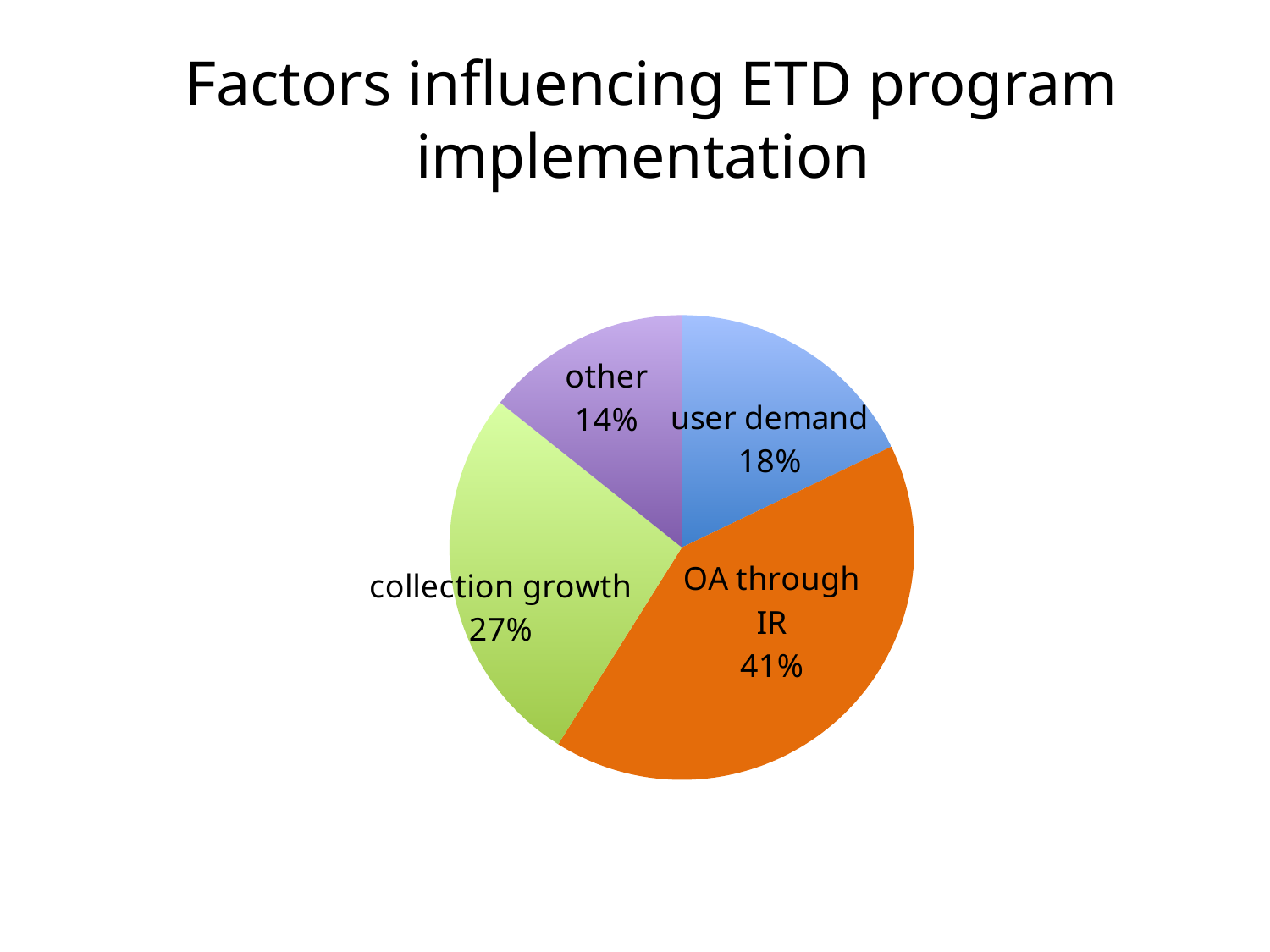
What share of the pie does collection growth account for? 27% How many slices does the pie chart have? 4 What is the title of the slide containing the pie chart? Factors influencing ETD program implementation What is the difference in percentage points between OA through IR and collection growth? 14 What share of the pie does the other slice account for? 14% What kind of chart is shown on the slide? pie chart What is the difference in percentage points between user demand and other? 4 Which is larger, the share for collection growth or the share for user demand? collection growth What share of the pie does user demand account for? 18% Which factor has the smallest share of the pie? other Which factor has the largest share of the pie? OA through IR